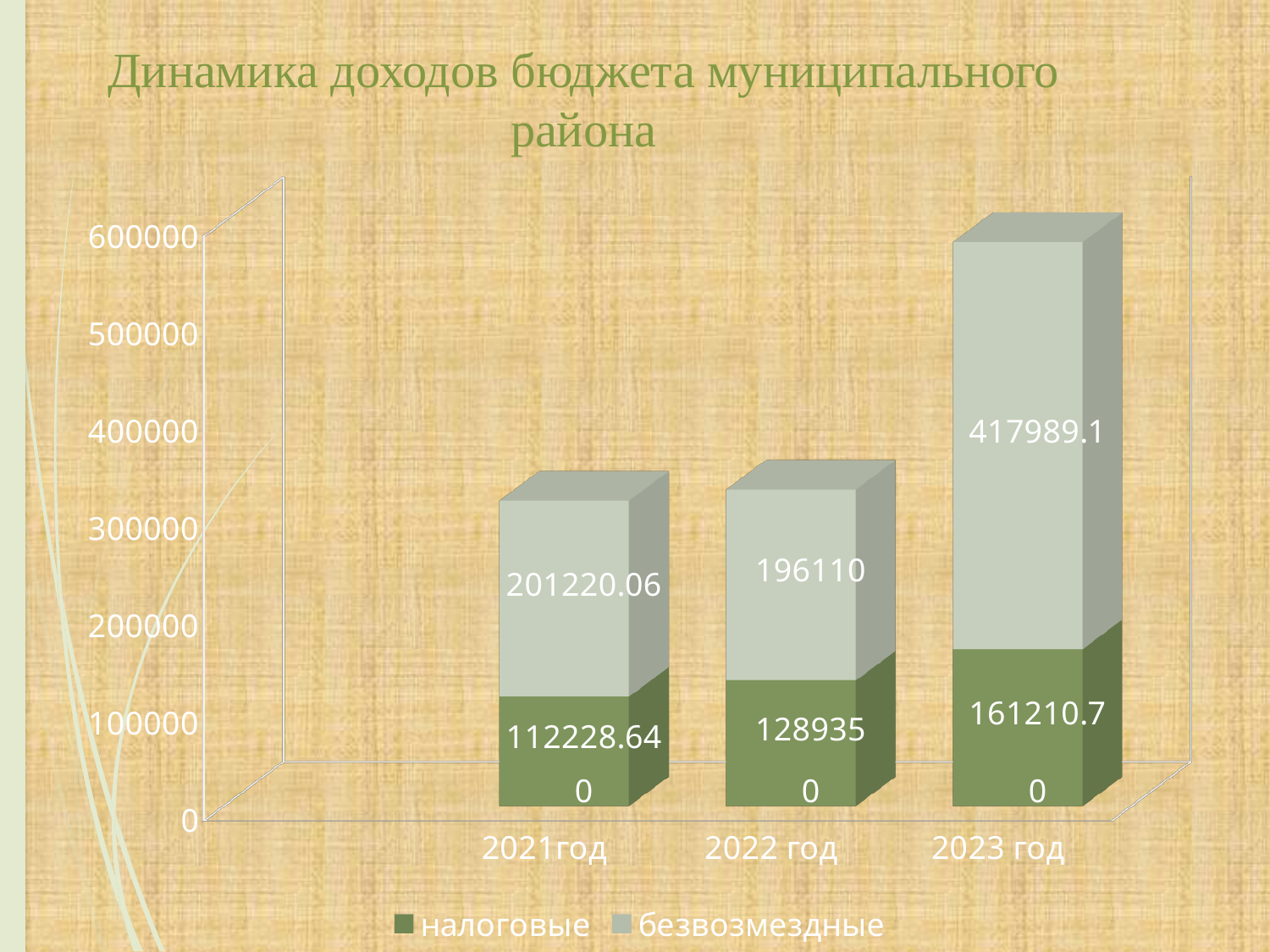
How many years are shown on the x axis? 3 Which year has the lowest value for налоговые? 2021год Which is larger: безвозмездные for 2021год or безвозмездные for 2022 год? 2021год What is the difference between the безвозмездные values for 2023 год and 2022 год? 221879.1 What is the value of налоговые for 2022 год? 128935 Do the налоговые values rise or fall from 2021год to 2023 год? rise How many series does the legend list? 2 What is the value of безвозмездные for 2021год? 201220.06 Which year has the highest value for безвозмездные? 2023 год What is the value of налоговые for 2021год? 112228.64 What is the value of безвозмездные for 2023 год? 417989.1 What is the total of the stacked bar for 2022 год? 325045